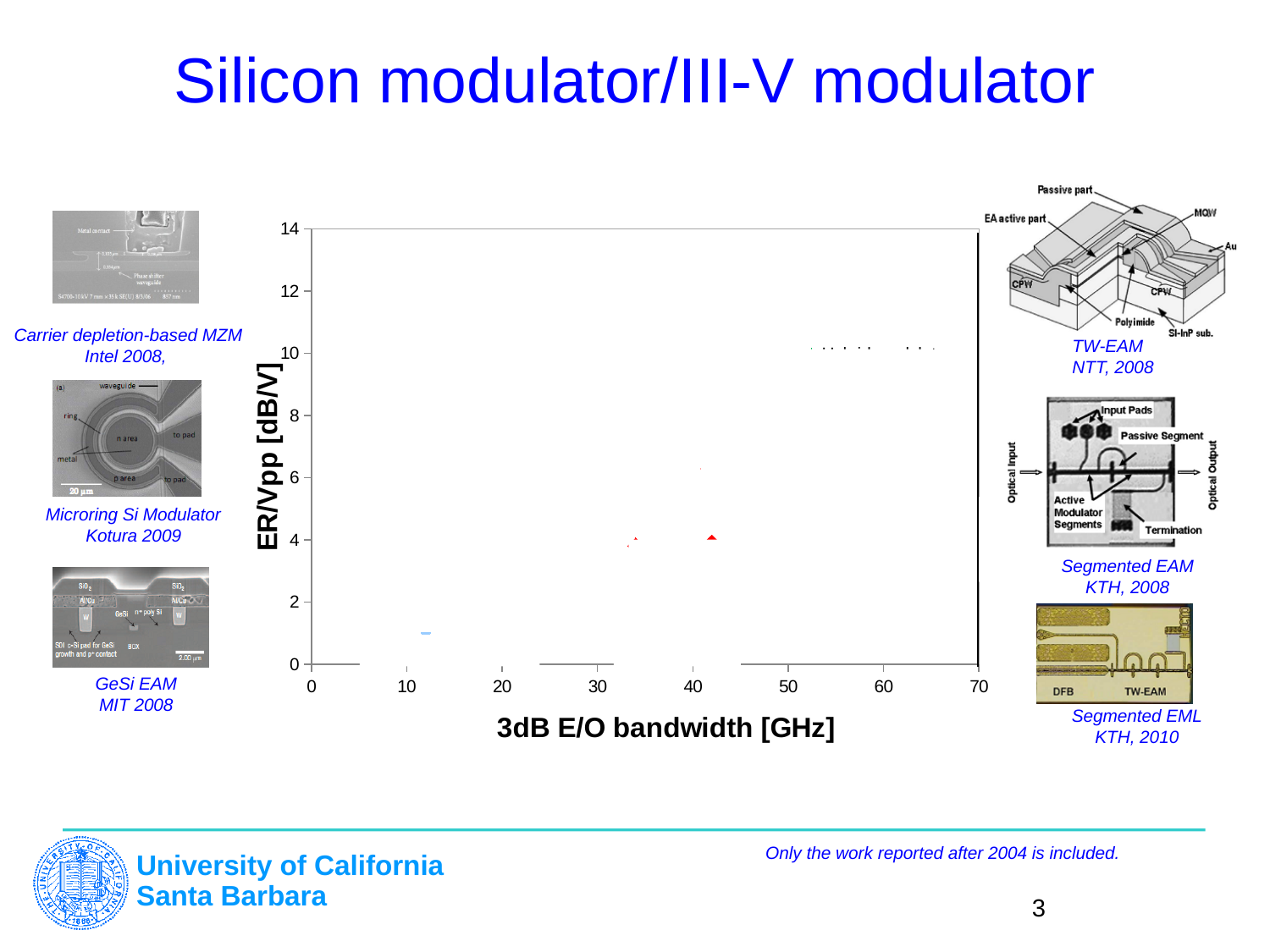
Is the ER/Vpp value of the row of dots between 50 and 70 GHz greater or less than 8? greater Is the ER/Vpp value of the light blue marker near 12 GHz greater or less than 2? less Is the ER/Vpp value of the red triangle marker greater or less than 6? less What kind of chart is shown in the centre of the slide? scatter chart What is the title of the x axis of the chart? 3dB E/O bandwidth [GHz] What is the title of the y axis of the chart? ER/Vpp [dB/V]